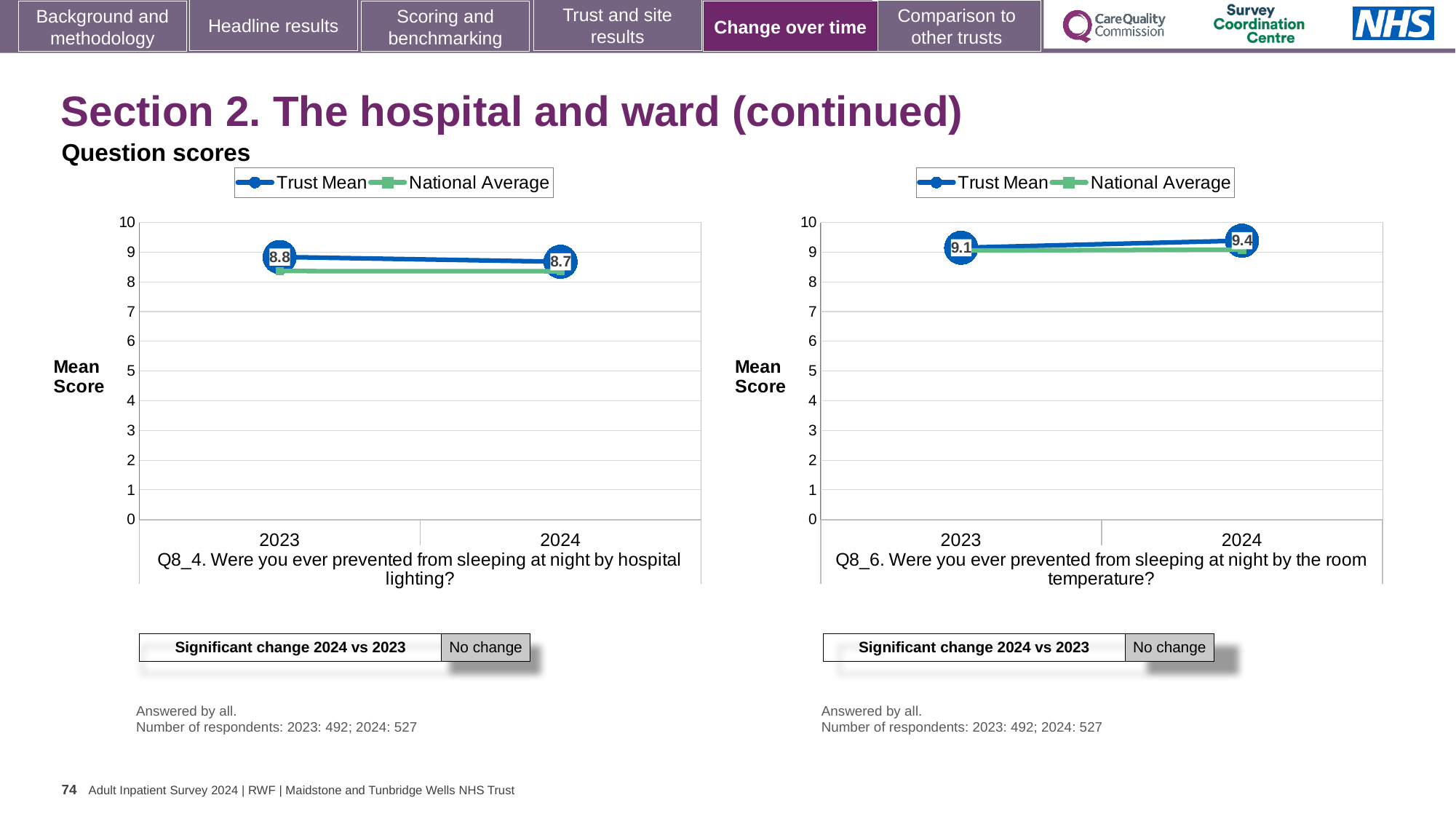
In the Q8_6 room temperature chart, does the Trust Mean rise or fall from 2023 to 2024? rise What kind of chart is the Q8_4 hospital lighting chart? line chart How many years are shown on the x axis of the Q8_6 room temperature chart? 2 In the Q8_6 room temperature chart, which is larger in 2024, the Trust Mean or the National Average? Trust Mean How many series does the legend of the Q8_4 hospital lighting chart list? 2 In the Q8_6 room temperature chart, by how much did the Trust Mean change from 2023 to 2024? 0.3 In the Q8_6 room temperature chart, what is the Trust Mean score for 2023? 9.1 In the Q8_4 hospital lighting chart, what is the Trust Mean score for 2024? 8.7 In the Q8_6 room temperature chart, what is the Trust Mean score for 2024? 9.4 In the Q8_4 hospital lighting chart, does the Trust Mean rise or fall from 2023 to 2024? fall In the Q8_4 hospital lighting chart, is the National Average for 2024 greater or less than 9? less In the Q8_4 hospital lighting chart, what is the Trust Mean score for 2023? 8.8